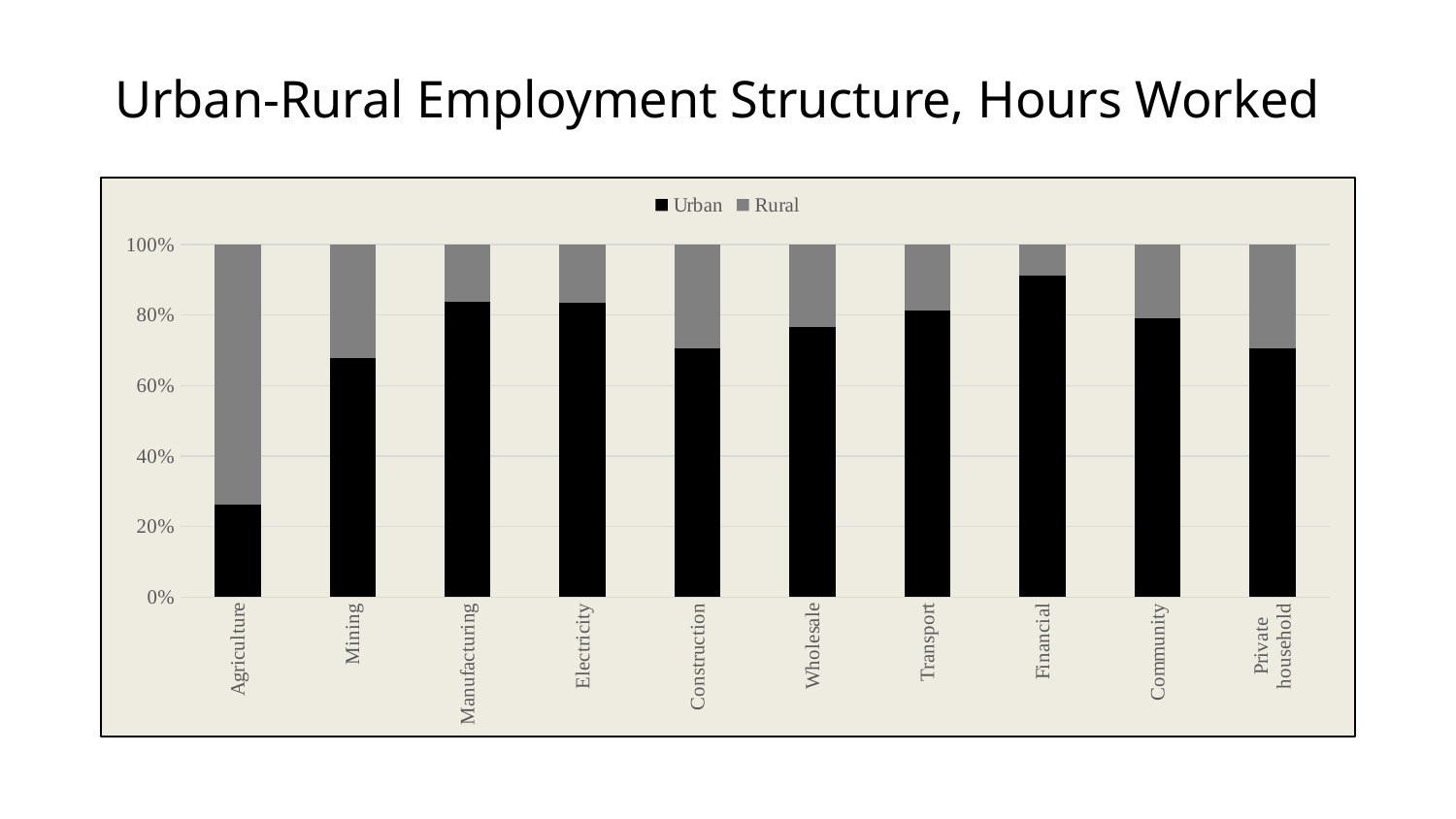
Which category has the largest Rural share? Agriculture Is the Urban share for Agriculture greater or less than 40%? less Which has the larger Urban share, Mining or Manufacturing? Manufacturing How many series does the legend list? 2 How many industry categories are shown on the x axis? 10 Which category has the highest Urban share? Financial What is the title of the chart? Urban-Rural Employment Structure, Hours Worked Is the Urban share for Financial greater or less than 80%? greater Which category has the lowest Urban share? Agriculture What kind of chart is shown on the slide? Stacked bar chart Is the Urban share for Mining greater or less than 60%? greater Which colour represents the Rural series in the legend? Grey